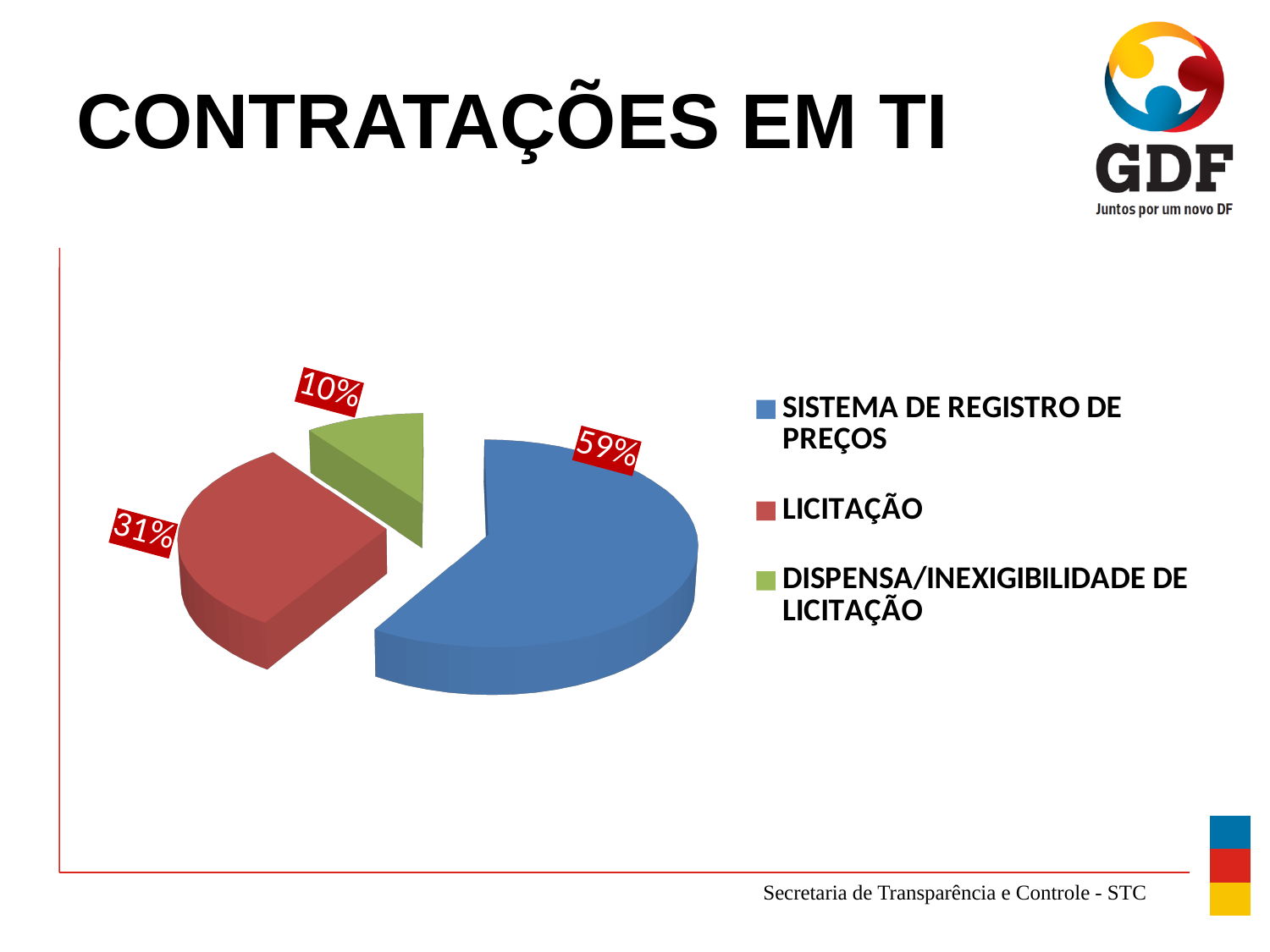
What is the title of the slide containing the chart? CONTRATAÇÕES EM TI Which is larger, the share for LICITAÇÃO or the share for DISPENSA/INEXIGIBILIDADE DE LICITAÇÃO? LICITAÇÃO What share of the pie does SISTEMA DE REGISTRO DE PREÇOS represent? 59% What share of the pie does LICITAÇÃO represent? 31% Which category has the smallest slice of the pie? DISPENSA/INEXIGIBILIDADE DE LICITAÇÃO How many categories does the pie chart show? 3 Which category has the largest slice of the pie? SISTEMA DE REGISTRO DE PREÇOS What colour is the slice for LICITAÇÃO? red What kind of chart is shown on the slide? pie chart What is the difference in percentage points between LICITAÇÃO and DISPENSA/INEXIGIBILIDADE DE LICITAÇÃO? 21 What share of the pie does DISPENSA/INEXIGIBILIDADE DE LICITAÇÃO represent? 10% What is the difference in percentage points between SISTEMA DE REGISTRO DE PREÇOS and LICITAÇÃO? 28